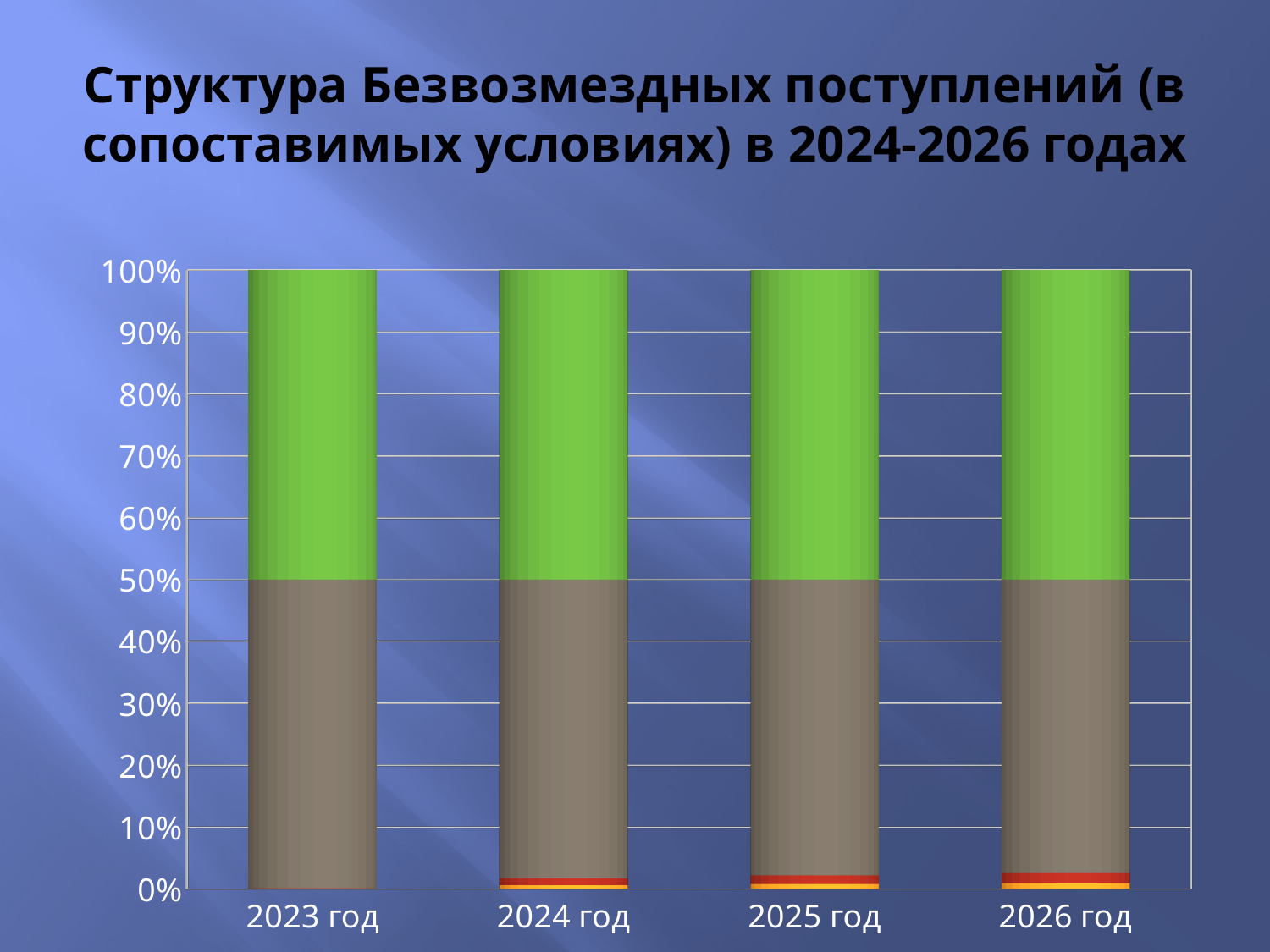
How many year categories are shown on the x axis of the chart? 4 What is the highest value shown on the vertical axis of the chart? 100% Is the green segment of the bar for 2025 год greater or less than 70%? less What is the title of the chart on the slide? Структура Безвозмездных поступлений (в сопоставимых условиях) в 2024-2026 годах Is the green segment of the bar for 2023 год greater or less than 40%? greater What is the total height of the stacked bar for 2023 год? 100% What is the total height of the stacked bar for 2026 год? 100% Is the red segment at the bottom of the bar for 2026 год greater or less than 10%? less Which category is the last one on the x axis of the chart? 2026 год What kind of chart is shown on the slide? bar chart Which category is the first one on the x axis of the chart? 2023 год